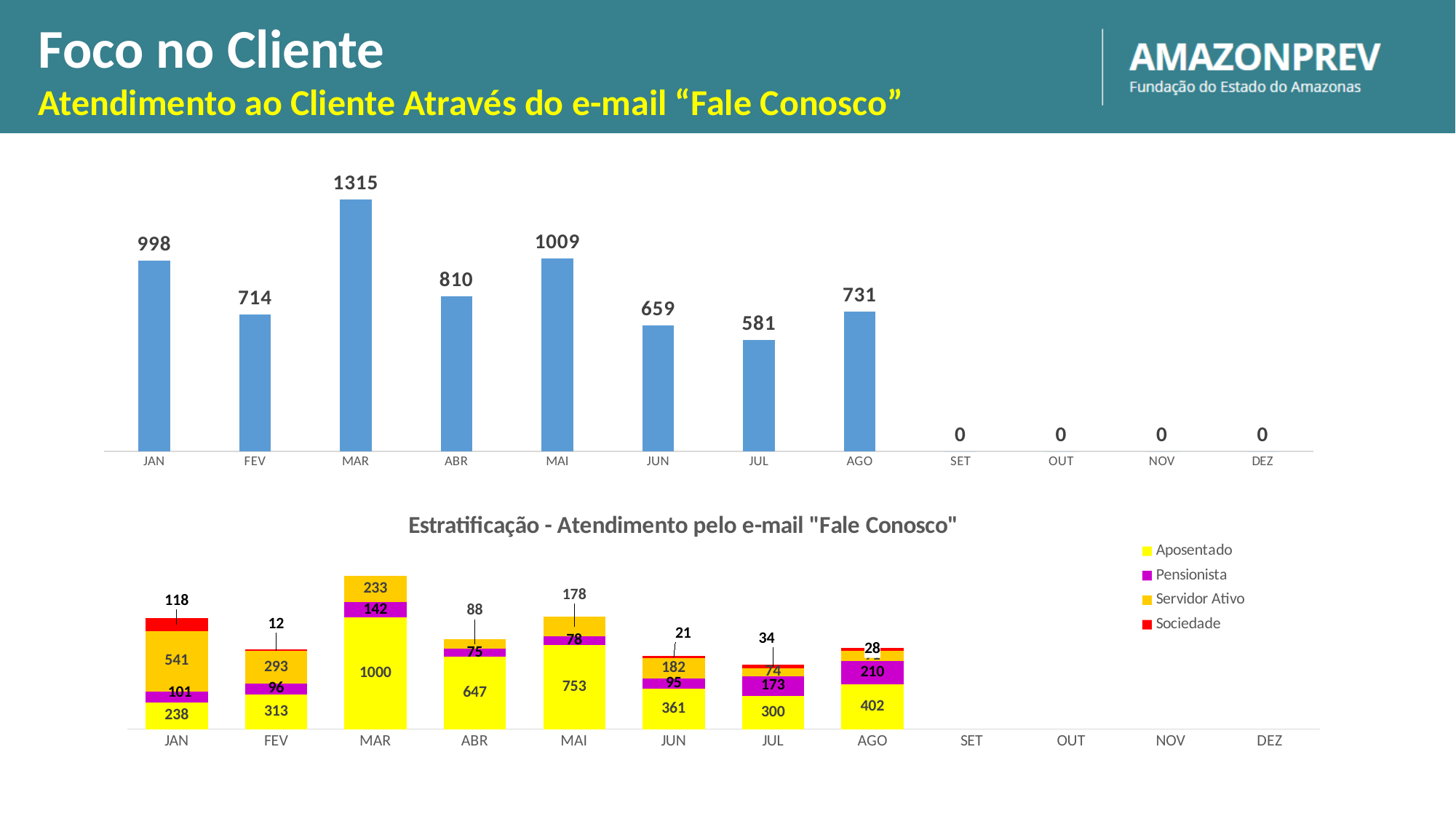
In the top chart, what is the difference between the values for JAN and FEV? 284 In the chart titled 'Estratificação - Atendimento pelo e-mail "Fale Conosco"', what is the Sociedade value for JAN? 118 What kind of chart is the chart titled 'Estratificação - Atendimento pelo e-mail "Fale Conosco"'? Stacked bar chart In the chart titled 'Estratificação - Atendimento pelo e-mail "Fale Conosco"', what is the total of the stacked bar for JUN? 659 In the chart titled 'Estratificação - Atendimento pelo e-mail "Fale Conosco"', what is the Aposentado value for MAR? 1000 In the top chart, how many months are shown on the x axis? 12 In the chart titled 'Estratificação - Atendimento pelo e-mail "Fale Conosco"', which series is shown in yellow? Aposentado In the top chart, which month has the highest value? MAR In the top chart, what is the value for MAR? 1315 In the top chart, which is larger, the value for ABR or the value for AGO? ABR In the top chart, what is the value for JUL? 581 In the chart titled 'Estratificação - Atendimento pelo e-mail "Fale Conosco"', how many series does the legend list? 4